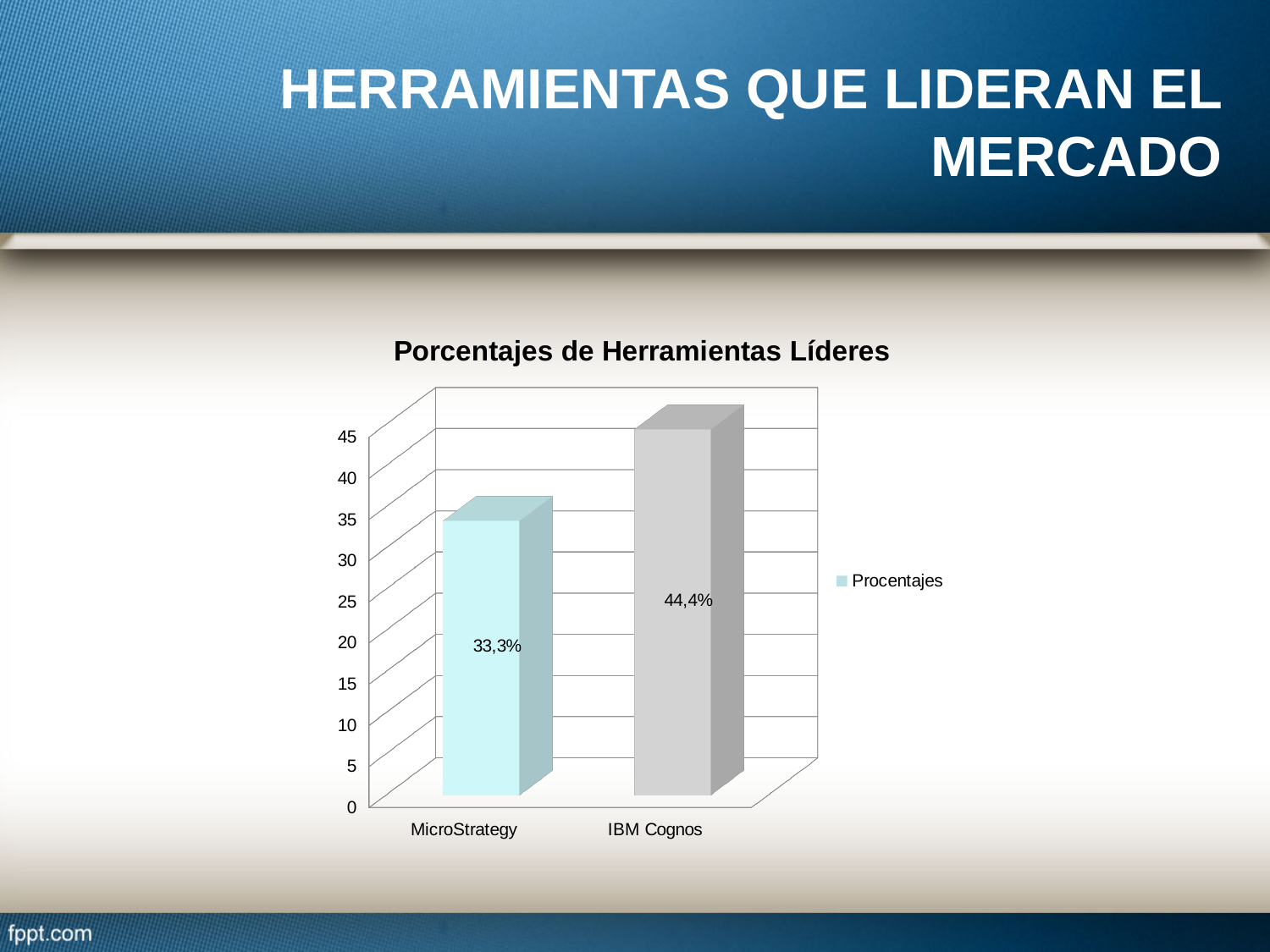
Which is larger, the value for MicroStrategy or the value for IBM Cognos? IBM Cognos How many categories are shown on the x axis? 2 Which category has the lowest value? MicroStrategy What is the difference between the values for IBM Cognos and MicroStrategy? 11,1% Which category has the highest value? IBM Cognos Is the value for MicroStrategy greater or less than 40? less What is the value for IBM Cognos? 44,4% Is the value for IBM Cognos greater or less than 40? greater How many series does the legend list? 1 What kind of chart is shown? bar chart What is the title of the chart? Porcentajes de Herramientas Líderes What is the value for MicroStrategy? 33,3%